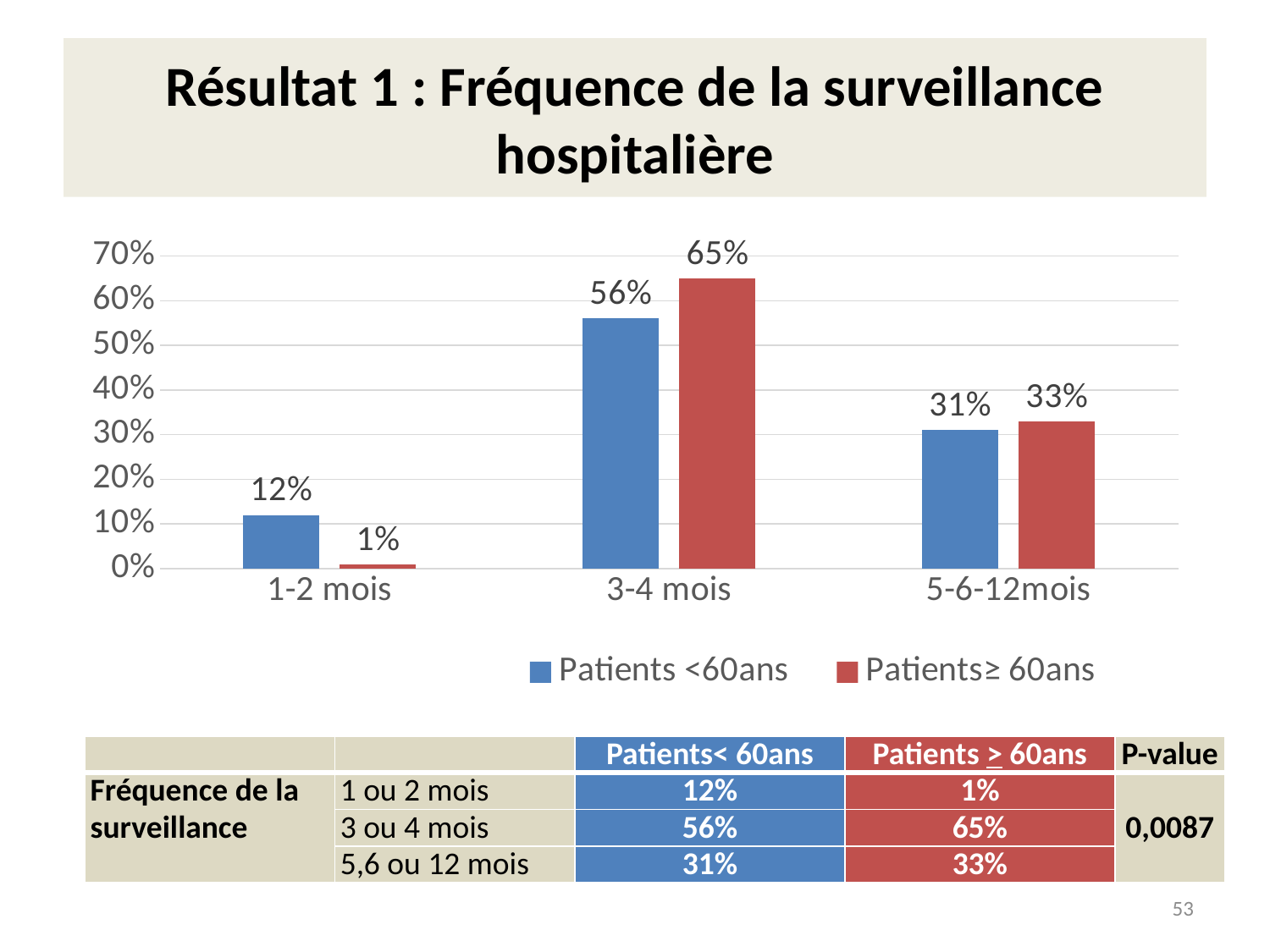
What is the value for Patients≥ 60ans in the 1-2 mois category? 1% How many categories are shown on the x axis? 3 Which category has the lowest value for Patients <60ans? 1-2 mois Is the value for Patients <60ans in the 5-6-12mois category greater or less than 40%? less How many series does the legend list? 2 What is the value for Patients <60ans in the 3-4 mois category? 56% What is the value for Patients≥ 60ans in the 5-6-12mois category? 33% Which category has the highest value for Patients≥ 60ans? 3-4 mois In the 1-2 mois category, which series has the larger value, Patients <60ans or Patients≥ 60ans? Patients <60ans What is the difference between Patients≥ 60ans and Patients <60ans in the 3-4 mois category? 9% What kind of chart is shown on the slide? bar chart What colour represents the Patients≥ 60ans series? red